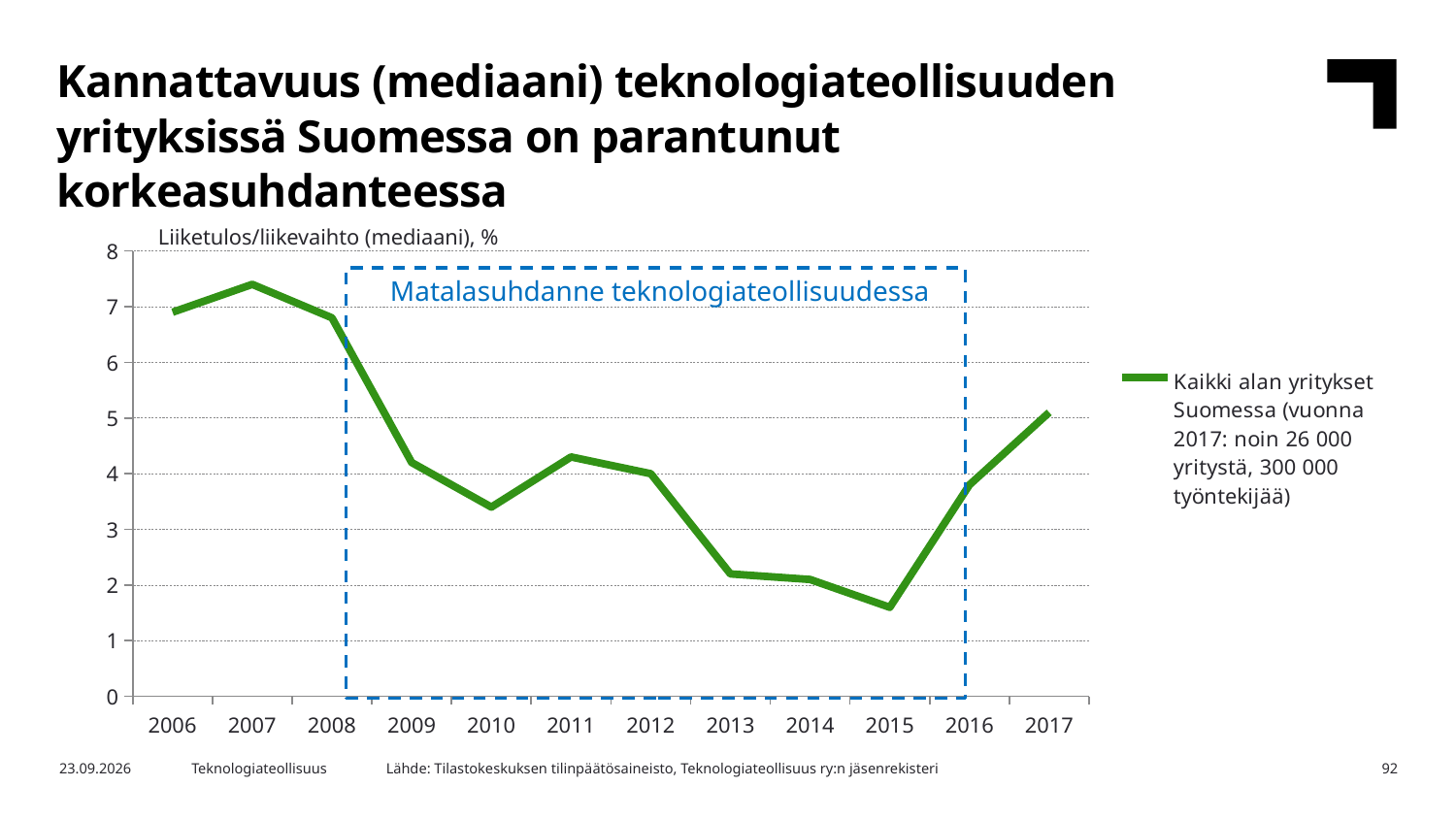
In which year is the plotted value highest? 2007 Is the value for 2006 greater or less than 6? greater Is the value for 2013 greater or less than 3? less How many years are plotted on the x axis of the chart? 12 Do the values rise or fall from 2015 to 2017? rise Which year has the larger value, 2011 or 2010? 2011 Is the value for 2010 greater or less than 4? less What kind of chart is shown on the slide? Line chart What is the label of the dashed box drawn over the chart? Matalasuhdanne teknologiateollisuudessa In which year is the plotted value lowest? 2015 How many series does the chart's legend list? 1